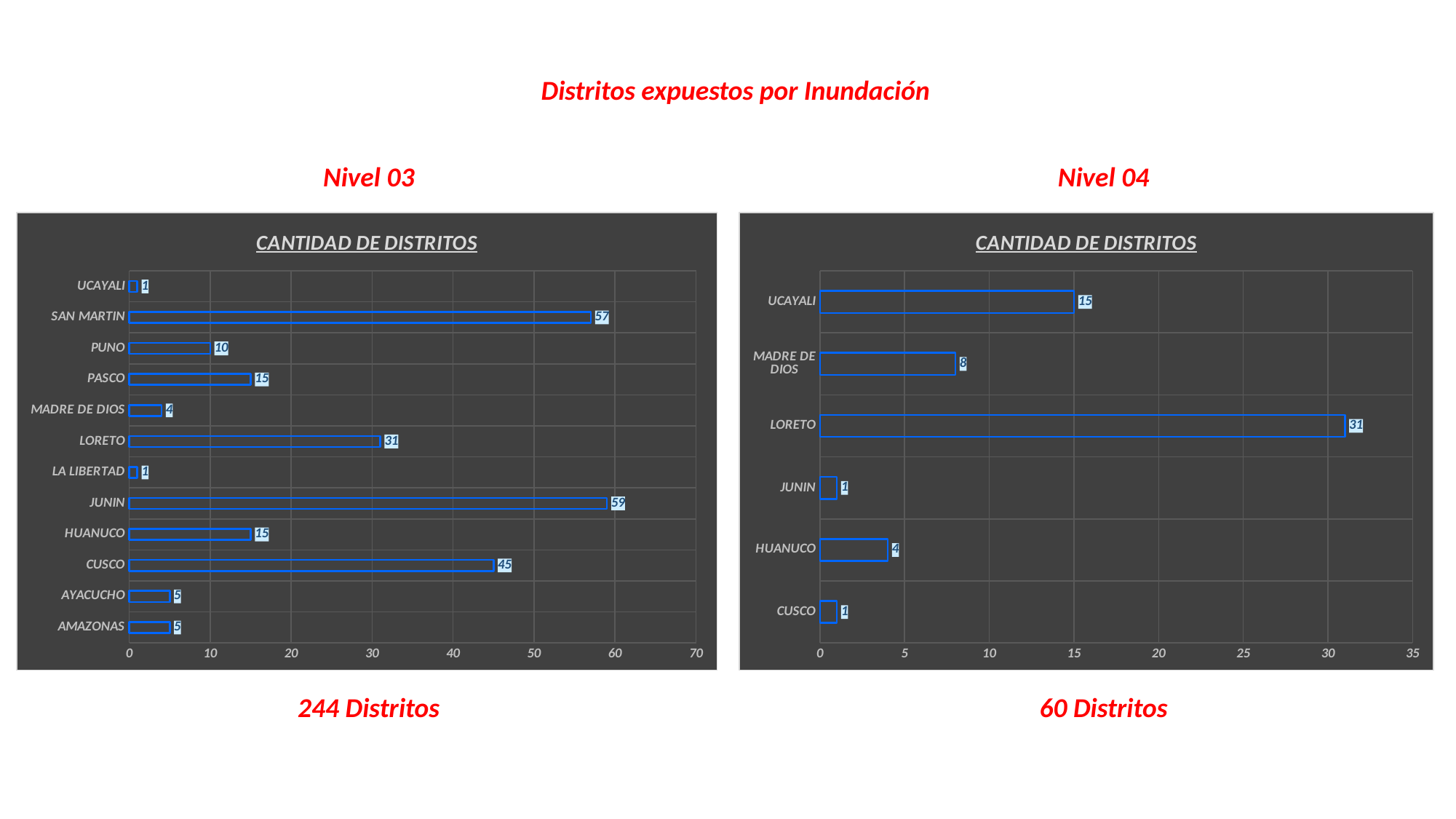
What is the title shown inside the Nivel 04 chart? CANTIDAD DE DISTRITOS What kind of chart is the Nivel 03 chart? Bar chart In the Nivel 03 chart, what is the difference between the values for JUNIN and CUSCO? 14 In the Nivel 04 chart, how many categories are plotted? 6 In the Nivel 04 chart, what is the difference between the values for LORETO and UCAYALI? 16 In the Nivel 03 chart, what is the value for LORETO? 31 In the Nivel 03 chart, how many categories are plotted? 12 In the Nivel 04 chart, which is larger, the value for UCAYALI or the value for HUANUCO? UCAYALI In the Nivel 03 chart, what is the value for SAN MARTIN? 57 In the Nivel 04 chart, what is the value for MADRE DE DIOS? 8 In the Nivel 04 chart, which category has the highest value? LORETO In the Nivel 03 chart, which category has the highest value? JUNIN